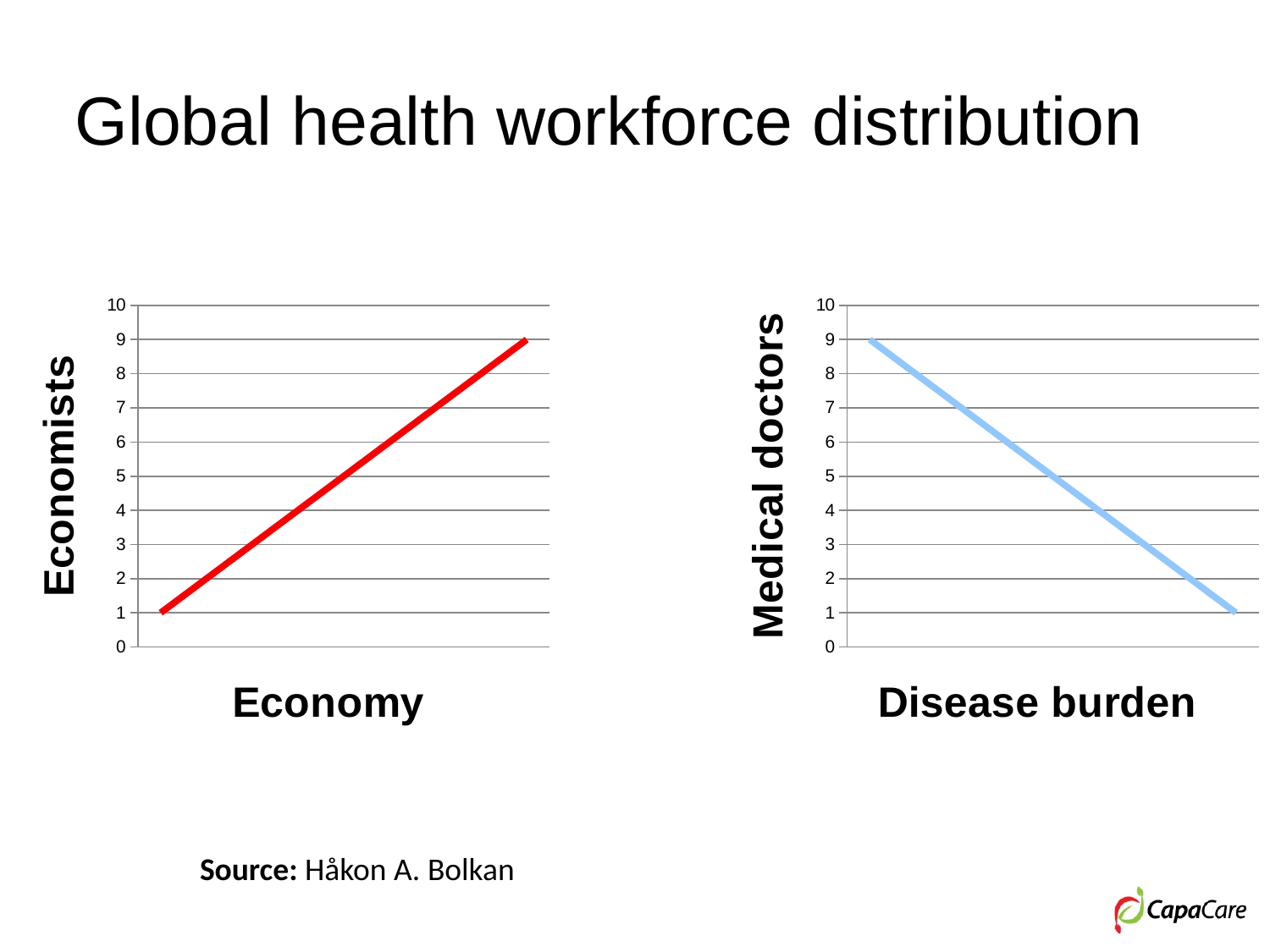
What kind of chart is the right chart (Medical doctors vs Disease burden)? line chart In the right chart, is the value at the right end of the line greater or less than 5? less What is the y-axis label of the left chart? Economists What is the x-axis label of the right chart? Disease burden In the right chart, what value does the line start at on its left end? 9 In the right chart, which end of the line has the larger value, the left end or the right end? left end In the right chart, do the values rise or fall as you move along the x axis (Disease burden)? fall In the left chart, is the value at the right end of the line greater or less than 5? greater In the left chart, do the values rise or fall as you move along the x axis (Economy)? rise What kind of chart is the left chart (Economists vs Economy)? line chart In the left chart, what value does the line start at on its left end? 1 In the left chart, which end of the line has the larger value, the left end or the right end? right end